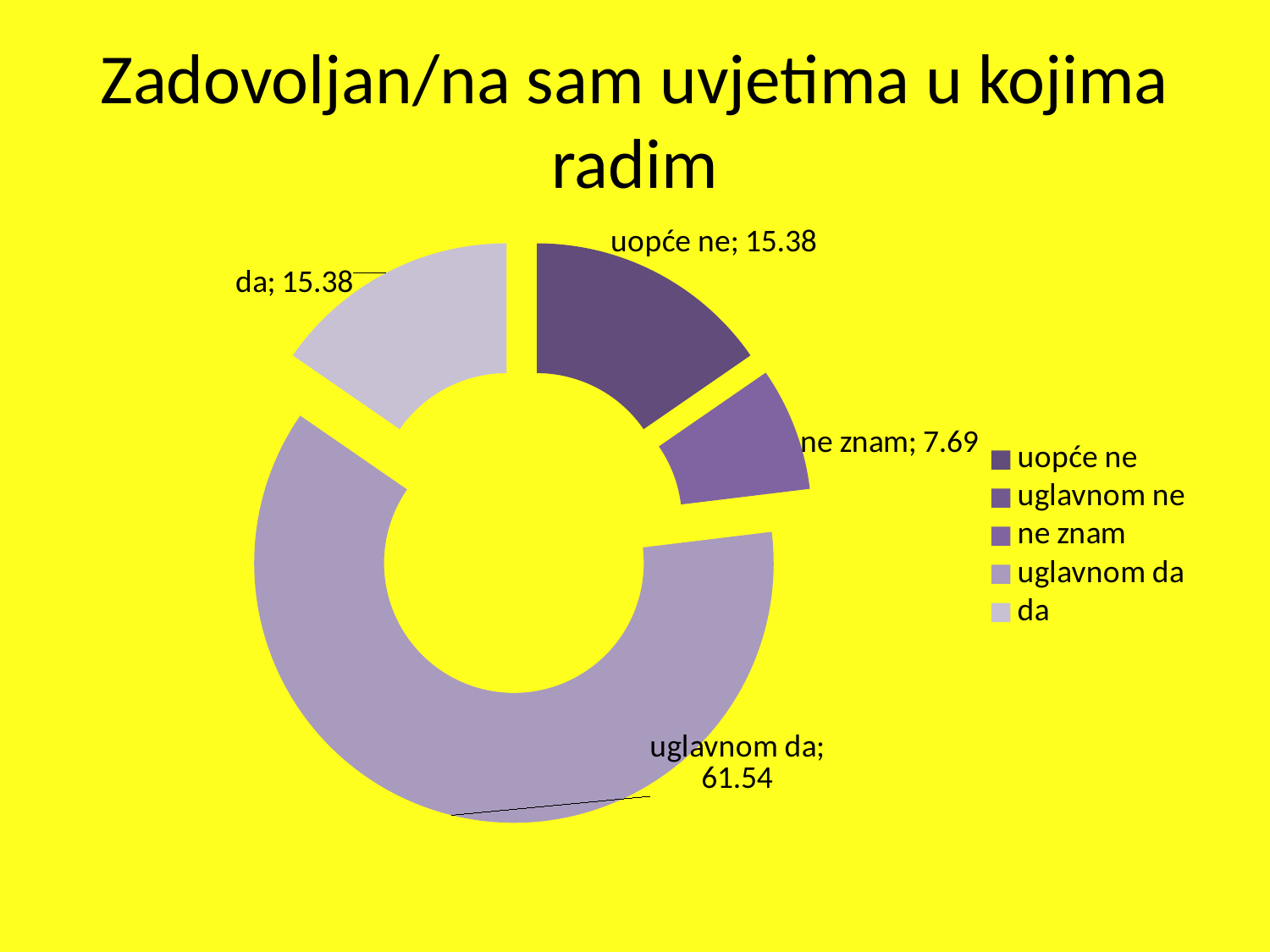
What is the value shown for "ne znam"? 7.69 What is the difference between the values for "uglavnom da" and "da"? 46.16 Which is larger, the value for "ne znam" or the value for "da"? da What is the value shown for "da"? 15.38 Which labelled category has the smallest value? ne znam What is the value shown for "uopće ne"? 15.38 What is the title of the chart? Zadovoljan/na sam uvjetima u kojima radim How many entries does the legend list? 5 What is the difference between the values for "uopće ne" and "ne znam"? 7.69 Which category has the largest share of the chart? uglavnom da What kind of chart is shown on the slide? doughnut (pie) chart What is the value shown for "uglavnom da"? 61.54